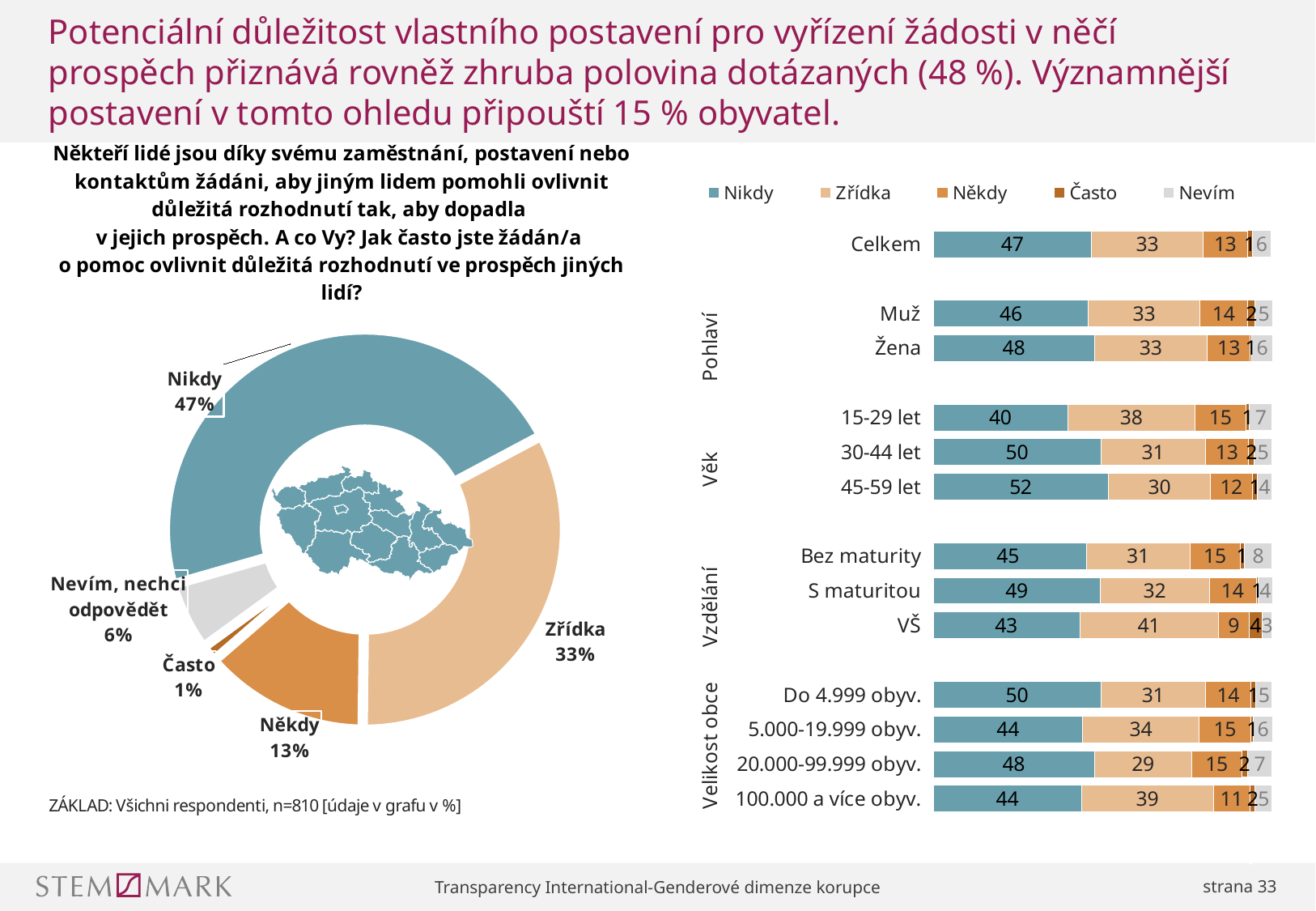
On the stacked bar chart on the right, which category has the highest "Nikdy" value? 45-59 let What kind of chart is shown on the left side of the slide? Donut (pie) chart On the stacked bar chart on the right, what is the "Zřídka" value for "VŠ"? 41 On the stacked bar chart on the right, what is the "Nikdy" value for "45-59 let"? 52 On the donut chart on the left, which category has the smallest share? Často On the donut chart on the left, how many slices are labelled? 5 On the stacked bar chart on the right, which category has the lowest "Nikdy" value? 15-29 let On the donut chart on the left, what share of respondents answered "Nikdy"? 47% On the donut chart on the left, what share of respondents answered "Zřídka"? 33% On the stacked bar chart on the right, is the "Nikdy" value larger for "Muž" or for "Žena"? Žena On the stacked bar chart on the right, what is the difference between the "Nikdy" values for "30-44 let" and "15-29 let"? 10 How many series does the legend of the stacked bar chart on the right list? 5